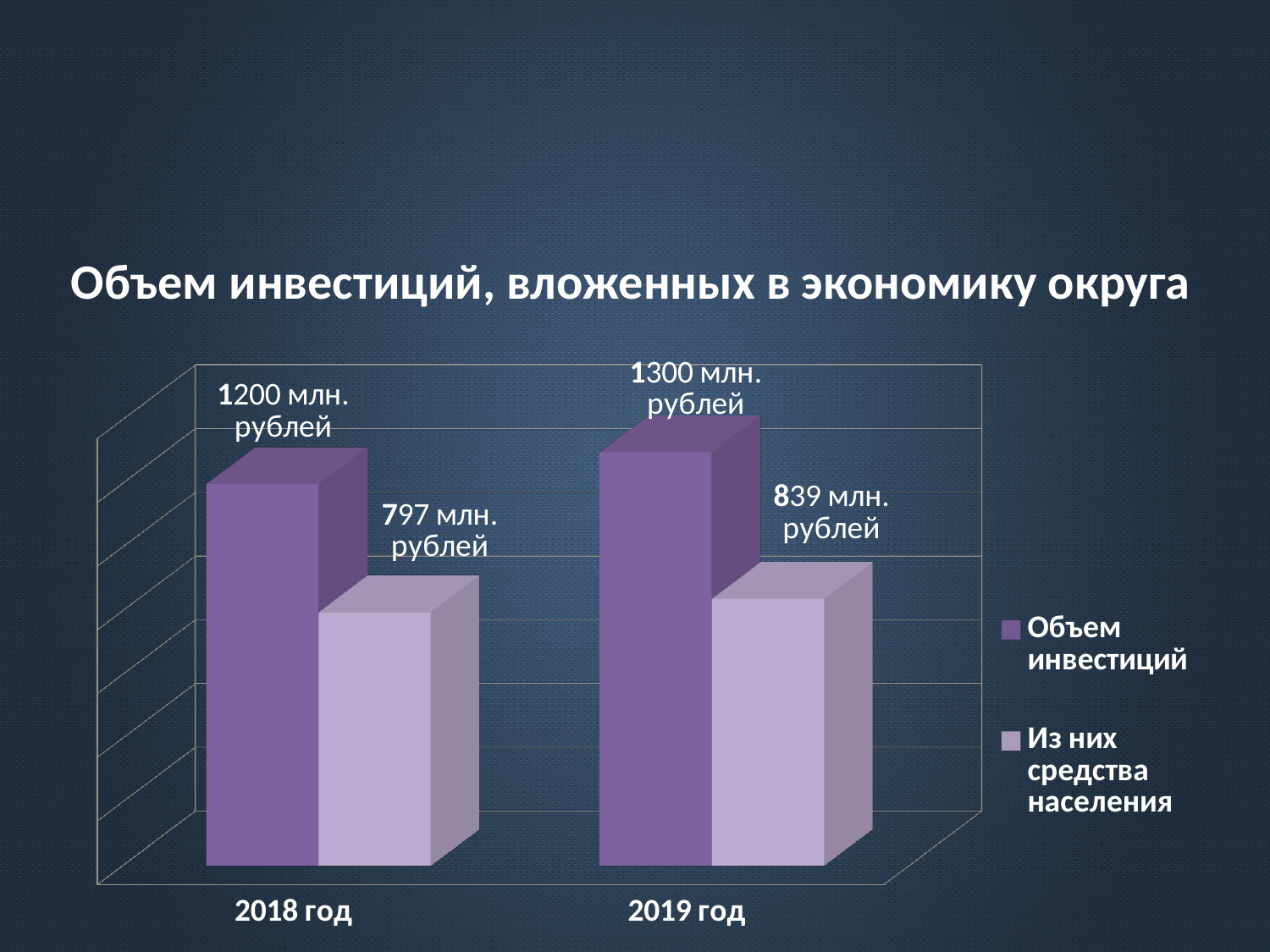
What is the value of "Из них средства населения" for 2018 год? 797 млн. рублей How many years (categories) are shown on the x axis? 2 What kind of chart is shown on the slide? bar chart Is "Объем инвестиций" in 2019 год larger or smaller than "Из них средства населения" in 2019 год? larger Which year has the higher value for "Объем инвестиций"? 2019 год What is the value of "Из них средства населения" for 2019 год? 839 млн. рублей What is the difference between "Объем инвестиций" and "Из них средства населения" in 2018 год? 403 млн. рублей Which year has the lower value for "Из них средства населения"? 2018 год What is the difference between "Объем инвестиций" in 2019 год and 2018 год? 100 млн. рублей How many series does the legend list? 2 What is the value of "Объем инвестиций" for 2018 год? 1200 млн. рублей What is the value of "Объем инвестиций" for 2019 год? 1300 млн. рублей